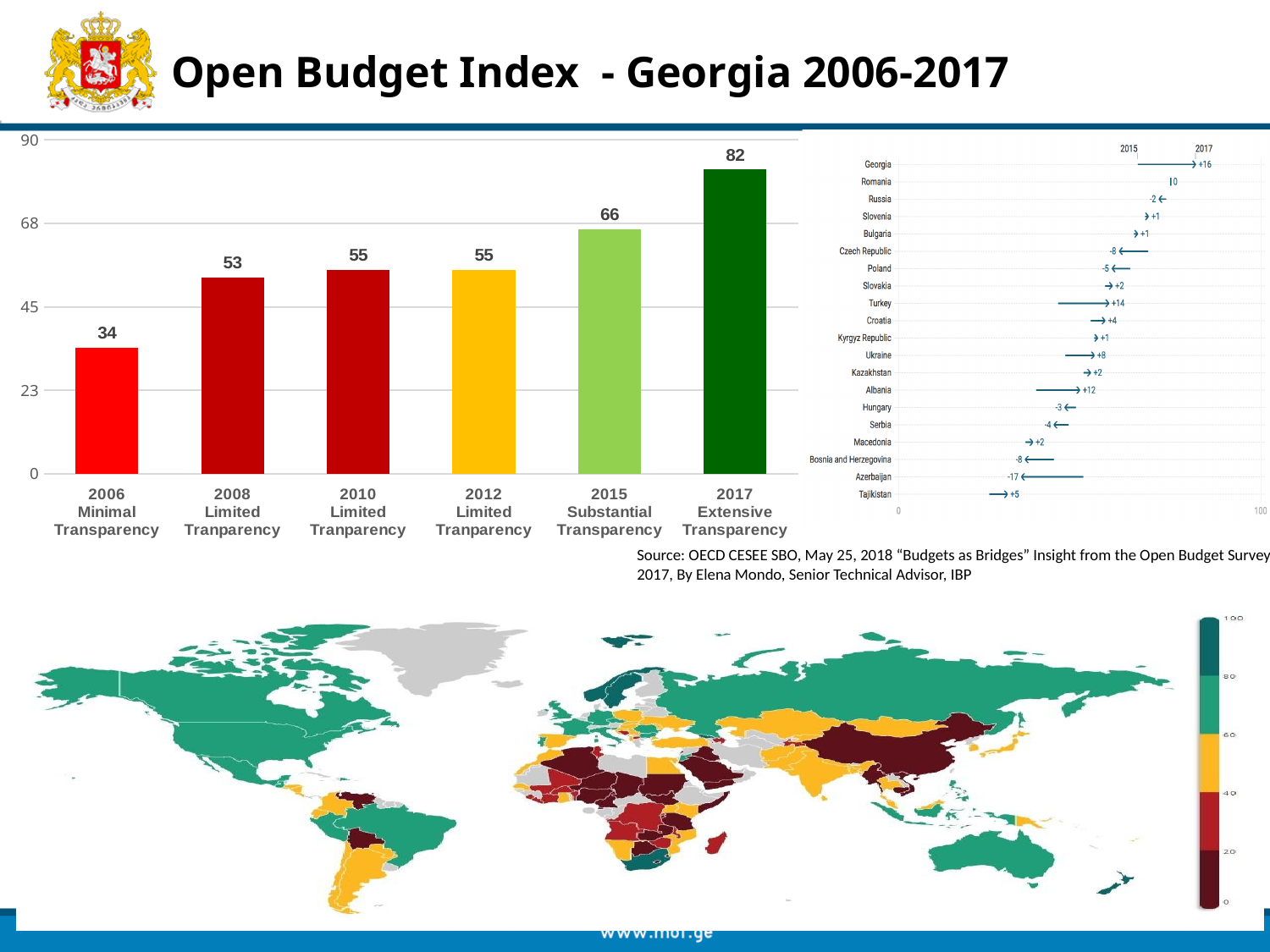
In the bar chart on the left, do the values generally rise or fall from 2006 to 2017? Rise In the bar chart on the left, which is larger, the value for 2008 or the value for 2015? 2015 In the bar chart on the left, which year has the highest value? 2017 In the bar chart on the left, how many years (bars) are shown? 6 What type of chart is the chart on the left of the slide? Bar chart In the bar chart on the left, what is the value shown for 2015? 66 In the bar chart on the left, what is the Open Budget Index value for Georgia in 2006? 34 In the bar chart on the left, what transparency category label is shown under 2017? Extensive Transparency In the bar chart on the left, what is the difference between the 2017 value and the 2006 value? 48 In the bar chart on the left, which year has the lowest value? 2006 In the chart on the right comparing 2015 and 2017, what change is shown for Azerbaijan? -17 In the chart on the right comparing 2015 and 2017, what change is shown for Georgia? +16